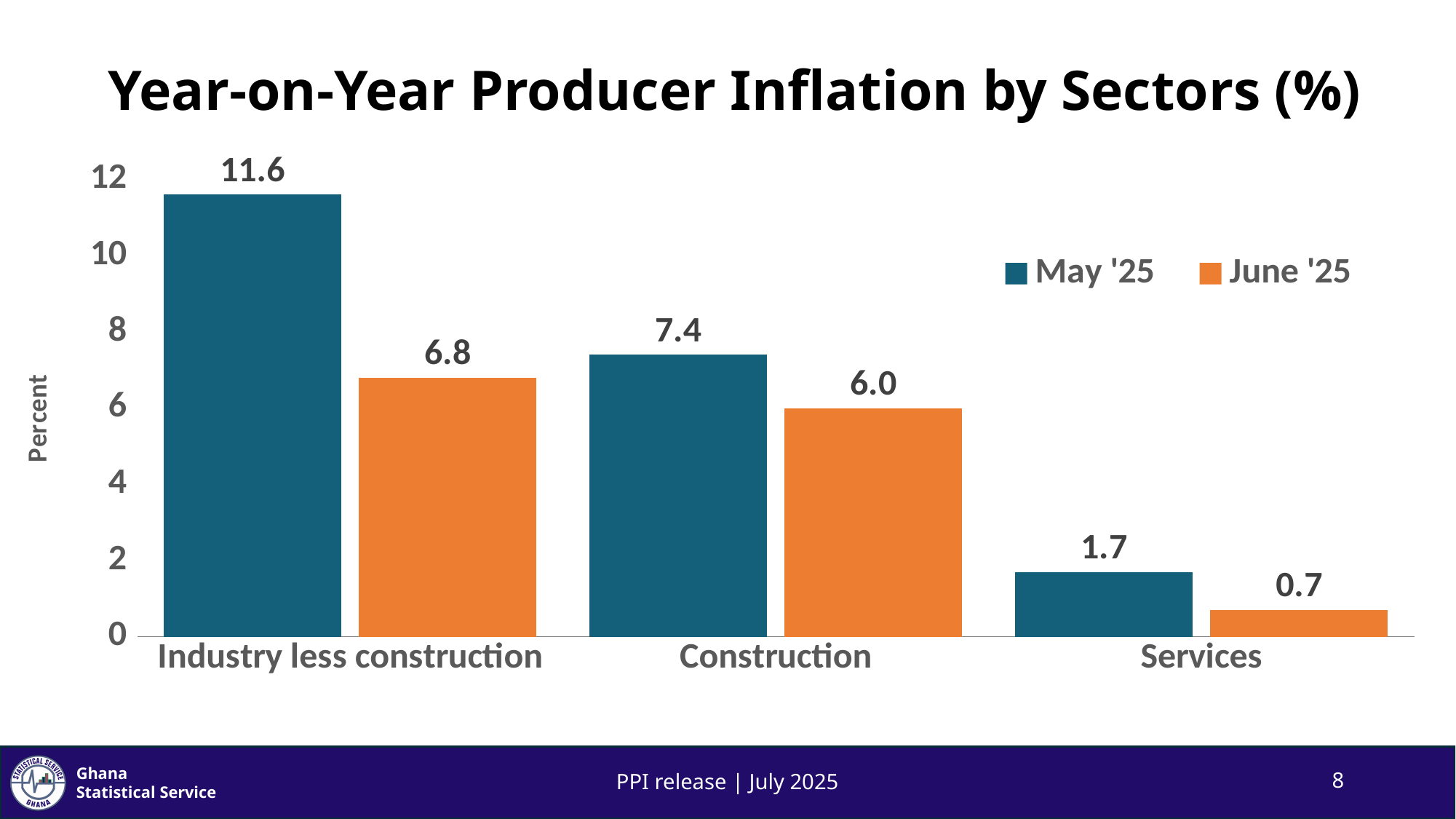
What kind of chart is shown on the slide? Bar chart What is the June '25 year-on-year producer inflation for Construction? 6.0 How many series does the legend list? 2 Is the June '25 value for Industry less construction greater or less than 8? less What is the June '25 value for Services? 0.7 Which sector has the lowest June '25 producer inflation? Services How many sectors are shown on the x axis? 3 What is the difference between the May '25 and June '25 values for Industry less construction? 4.8 Which is larger for Construction: the May '25 value or the June '25 value? May '25 What is the May '25 year-on-year producer inflation for Industry less construction? 11.6 What is the difference between the May '25 and June '25 values for Services? 1.0 Which sector has the highest May '25 producer inflation? Industry less construction